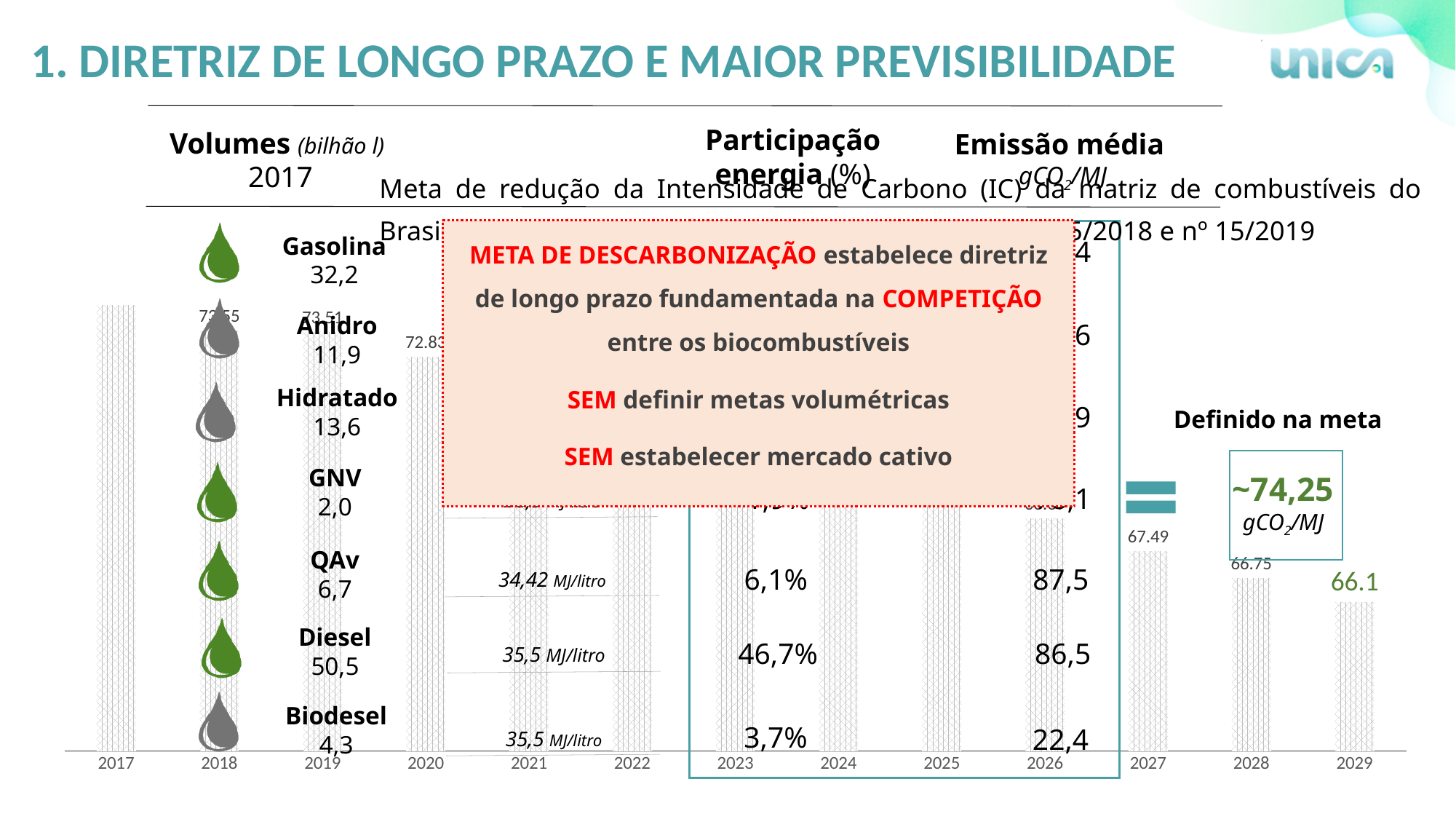
Which year has the lowest bar in the chart? 2029 What is the value labelled for 2027 in the bar chart? 67.49 How many years are shown on the x axis of the bar chart? 13 What is the difference between the values for 2027 and 2028? 0.74 What is the value labelled for 2019 in the bar chart? 73.51 What value is shown in the box under the label 'Definido na meta'? ~74,25 gCO2/MJ What is the value labelled for 2028 in the bar chart? 66.75 What kind of chart is shown on the slide? bar chart Which is larger, the value for 2020 or the value for 2029? 2020 What is the value labelled for 2029 in the bar chart? 66.1 What is the value labelled for 2020 in the bar chart? 72.83 Do the bar values rise or fall from 2020 to 2029? fall